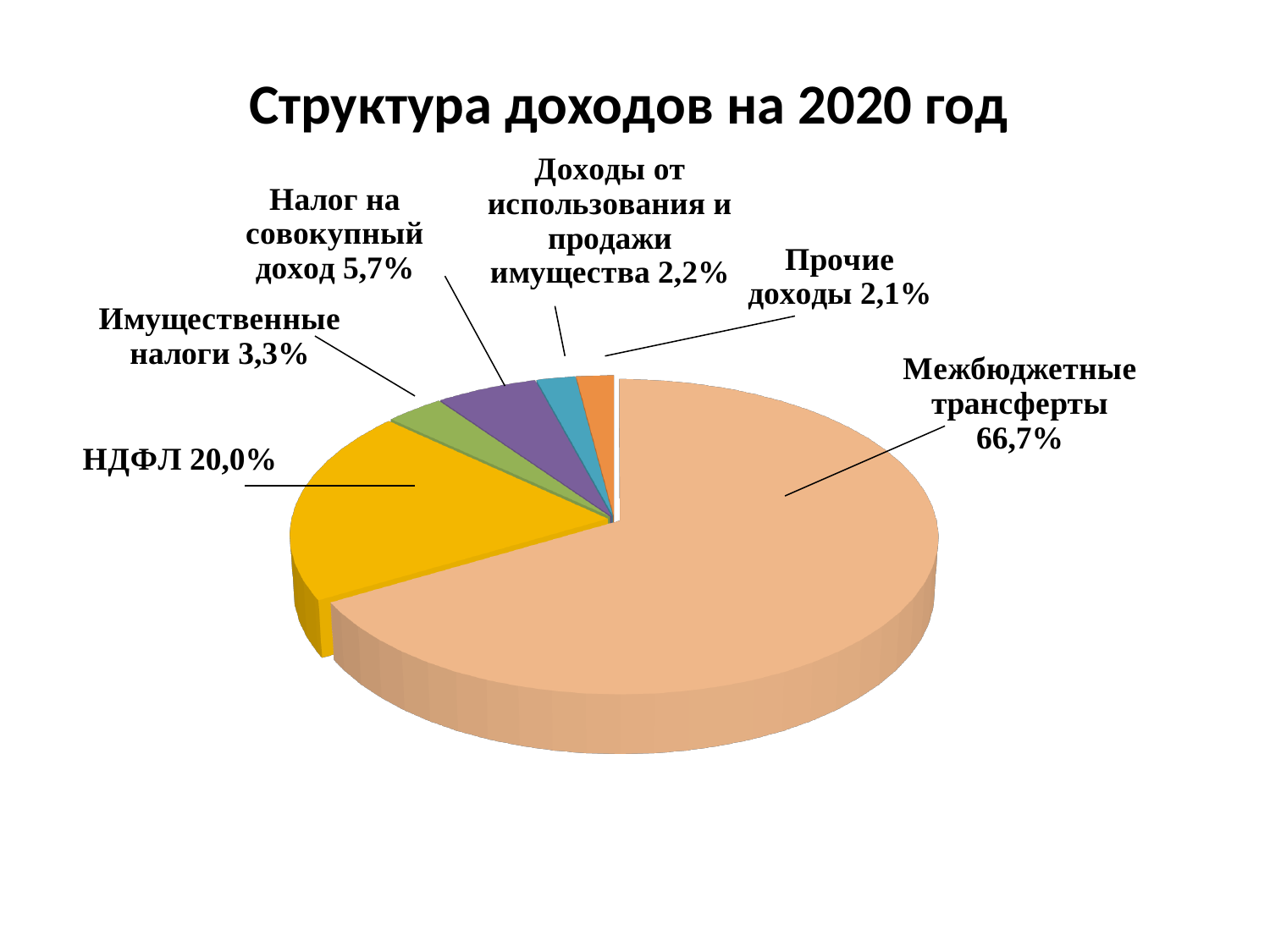
What is the difference between the shares of Межбюджетные трансферты and НДФЛ? 46,7% Which category has the largest share of the pie? Межбюджетные трансферты What is the value shown for НДФЛ? 20,0% What is the value shown for Налог на совокупный доход? 5,7% What is the title of the chart? Структура доходов на 2020 год What is the value shown for Доходы от использования и продажи имущества? 2,2% Which is larger, the share of Налог на совокупный доход or the share of Имущественные налоги? Налог на совокупный доход What share of the pie is Межбюджетные трансферты? 66,7% What kind of chart is shown on the slide? Pie chart What is the value shown for Имущественные налоги? 3,3% How many slices does the pie chart have? 6 Which category has the smallest share of the pie? Прочие доходы